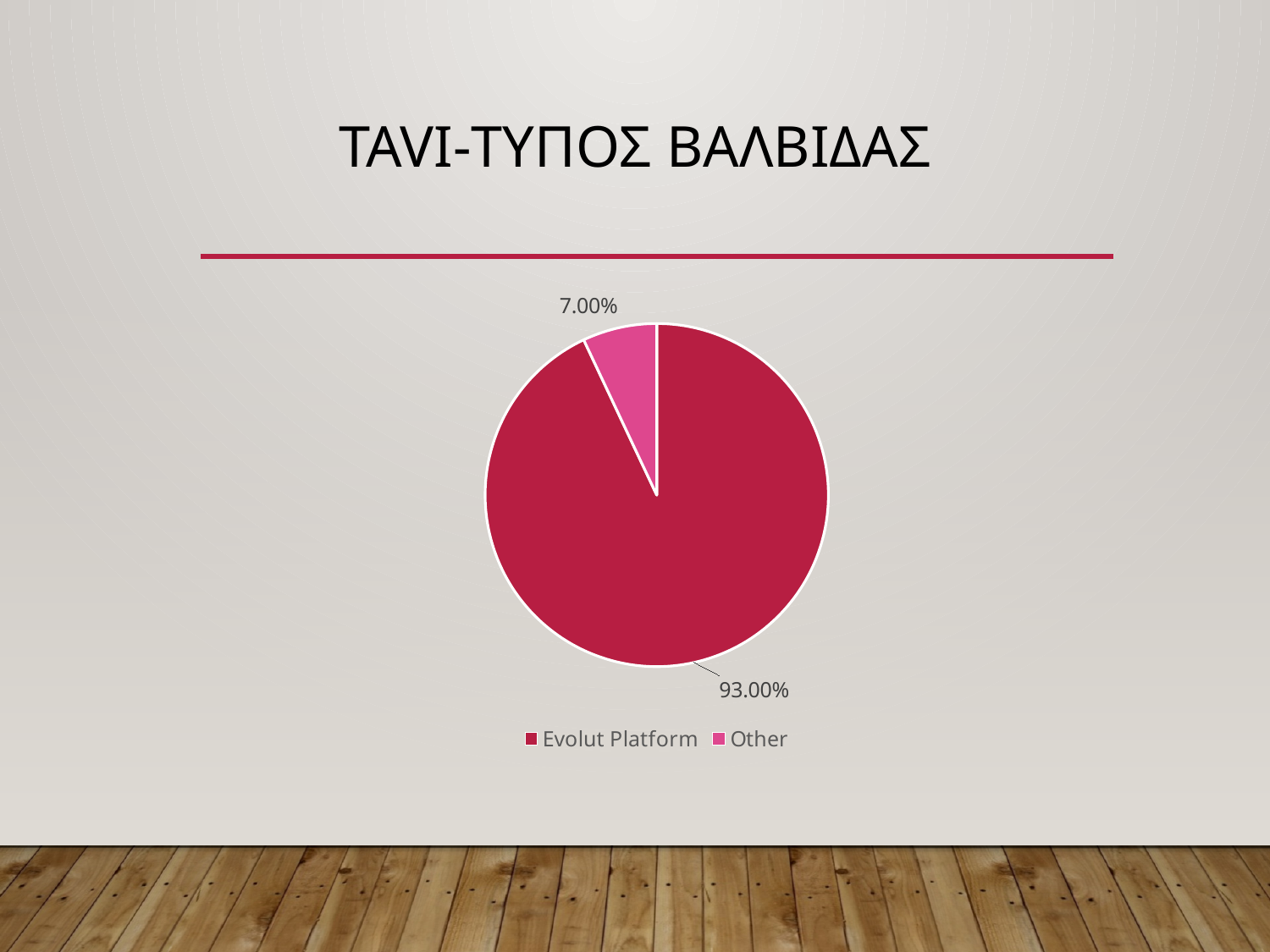
What is the title of the slide containing the pie chart? TAVI-ΤΥΠΟΣ ΒΑΛΒΙΔΑΣ What share of the pie does the Other slice represent? 7.00% How many slices does the pie chart have? 2 What percentage of the pie is labelled for Evolut Platform? 93.00% How many entries does the legend list? 2 Which category has the smallest slice of the pie? Other Which legend entry is shown in the lighter pink colour? Other What kind of chart is shown on the slide? pie chart Which category has the largest slice of the pie? Evolut Platform What is the difference in percentage points between the Evolut Platform slice and the Other slice? 86.00% What percentage of the pie is labelled for Other? 7.00% Which slice is larger, Evolut Platform or Other? Evolut Platform